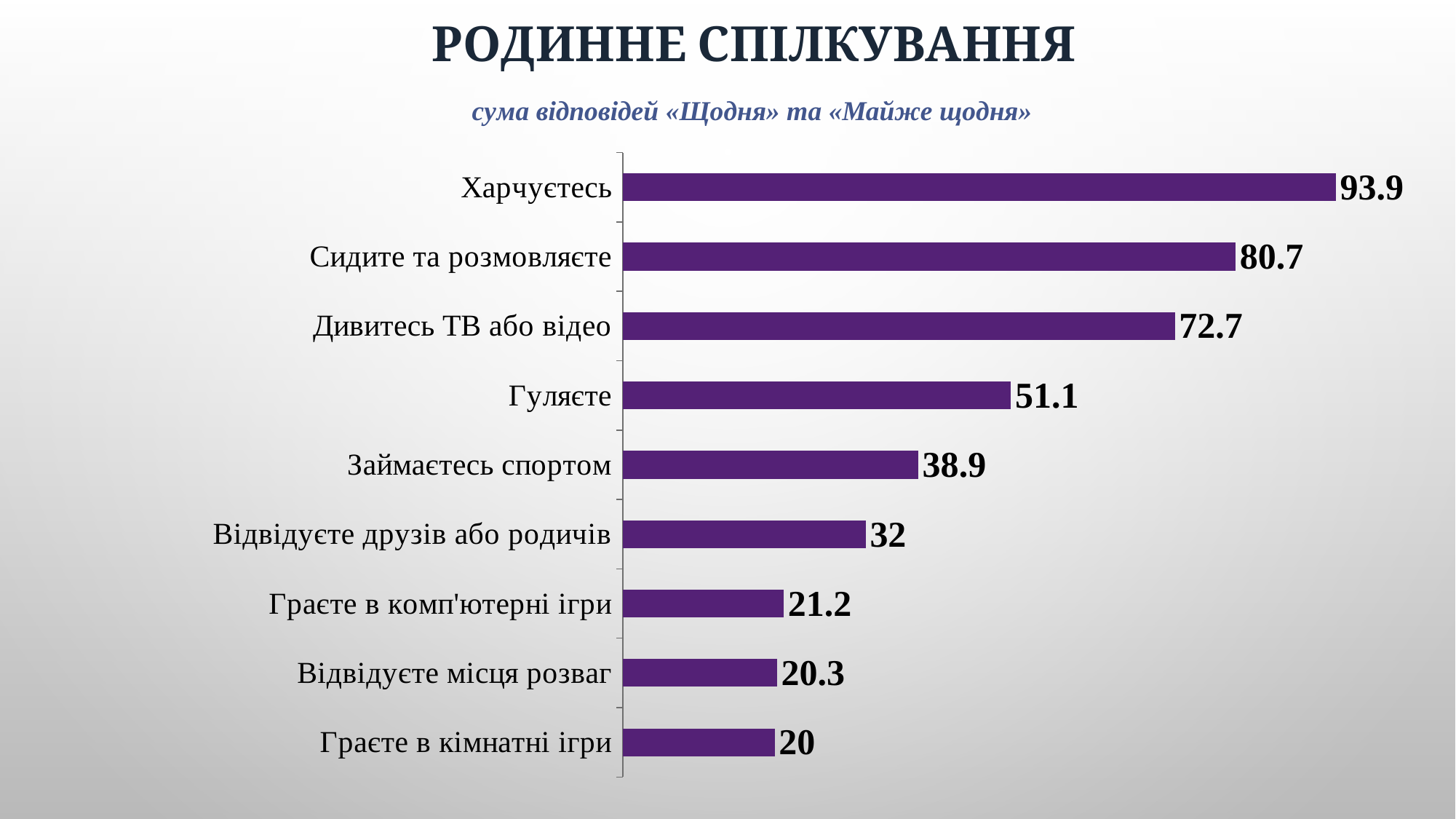
Which is larger, the value for Займаєтесь спортом or the value for Відвідуєте друзів або родичів? Займаєтесь спортом What is the value for Граєте в кімнатні ігри? 20 What is the value for Гуляєте? 51.1 What is the value for Харчуєтесь? 93.9 What is the difference between the values for Харчуєтесь and Сидите та розмовляєте? 13.2 Which category has the lowest value? Граєте в кімнатні ігри What is the value for Відвідуєте друзів або родичів? 32 How many categories are shown in the chart? 9 Which category has the highest value? Харчуєтесь What is the title of the slide? РОДИННЕ СПІЛКУВАННЯ What kind of chart is shown on the slide? Bar chart What is the difference between the values for Дивитесь ТВ або відео and Гуляєте? 21.6